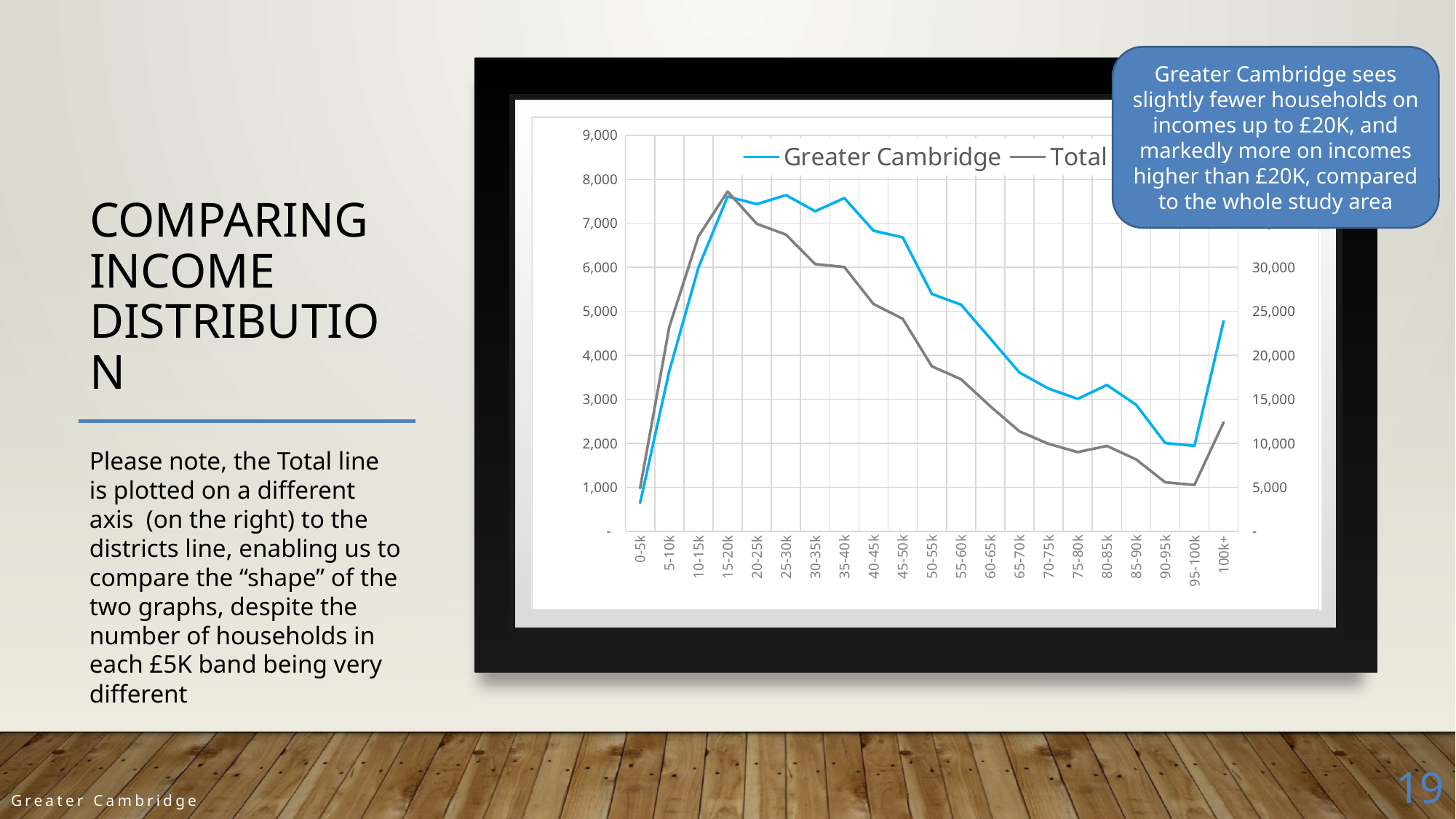
Which income band has the lowest value for the Greater Cambridge series? 0-5k Is the Greater Cambridge value for 0-5k greater or less than 1,000? less How many income bands are shown along the x axis of the chart? 21 For the Greater Cambridge series, which is larger: the value for 95-100k or the value for 100k+? 100k+ Which series is plotted on the right-hand axis of the chart? Total How many series does the chart legend list? 2 Is the Greater Cambridge value for 50-55k greater or less than 5,000? greater Which income band has the highest value for the Total series? 15-20k Is the Total value for 100k+ greater or less than 10,000 on the right-hand axis? greater What kind of chart is shown on the slide? line chart Does the Total series rise or fall between 15-20k and 95-100k? fall